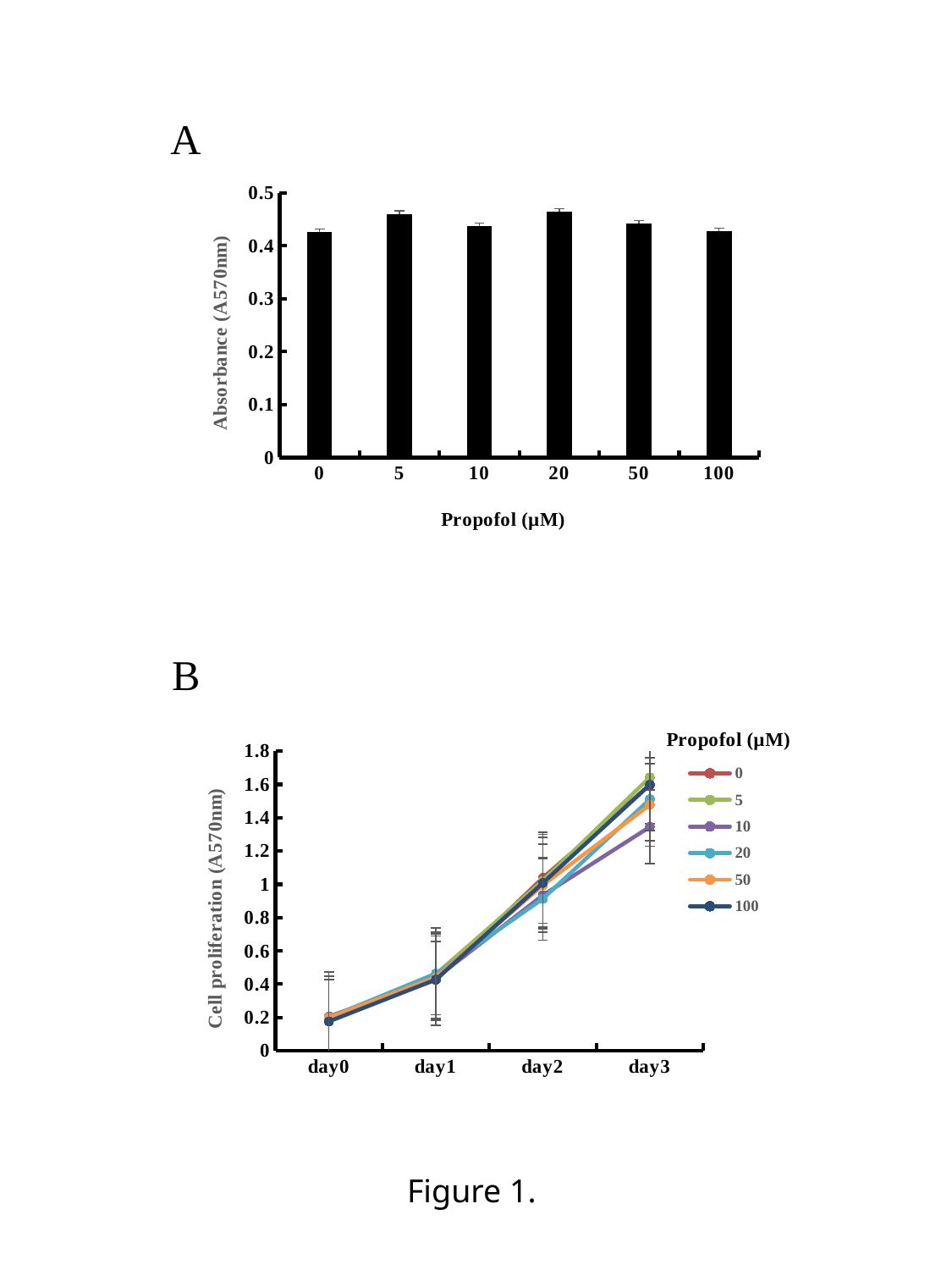
In chart B (bottom), is the value for the 10 µM series at day3 greater or less than 1.2? greater In chart B (bottom), is the value for the 0 µM series at day0 greater or less than 0.4? less In chart A (top), what is the label of the y axis? Absorbance (A570nm) In chart B (bottom), which series has the lowest value at day3? 10 In chart A (top), is the absorbance value for 20 µM propofol greater or less than 0.4? greater In chart B (bottom), how many time points are plotted on the x axis? 4 In chart B (bottom), do the cell proliferation values rise or fall from day0 to day3? rise In chart A (top), how many propofol concentrations are plotted on the x axis? 6 In chart B (bottom), what kind of chart is shown? line chart In chart A (top), what kind of chart is shown? bar chart In chart B (bottom), how many series does the legend list? 6